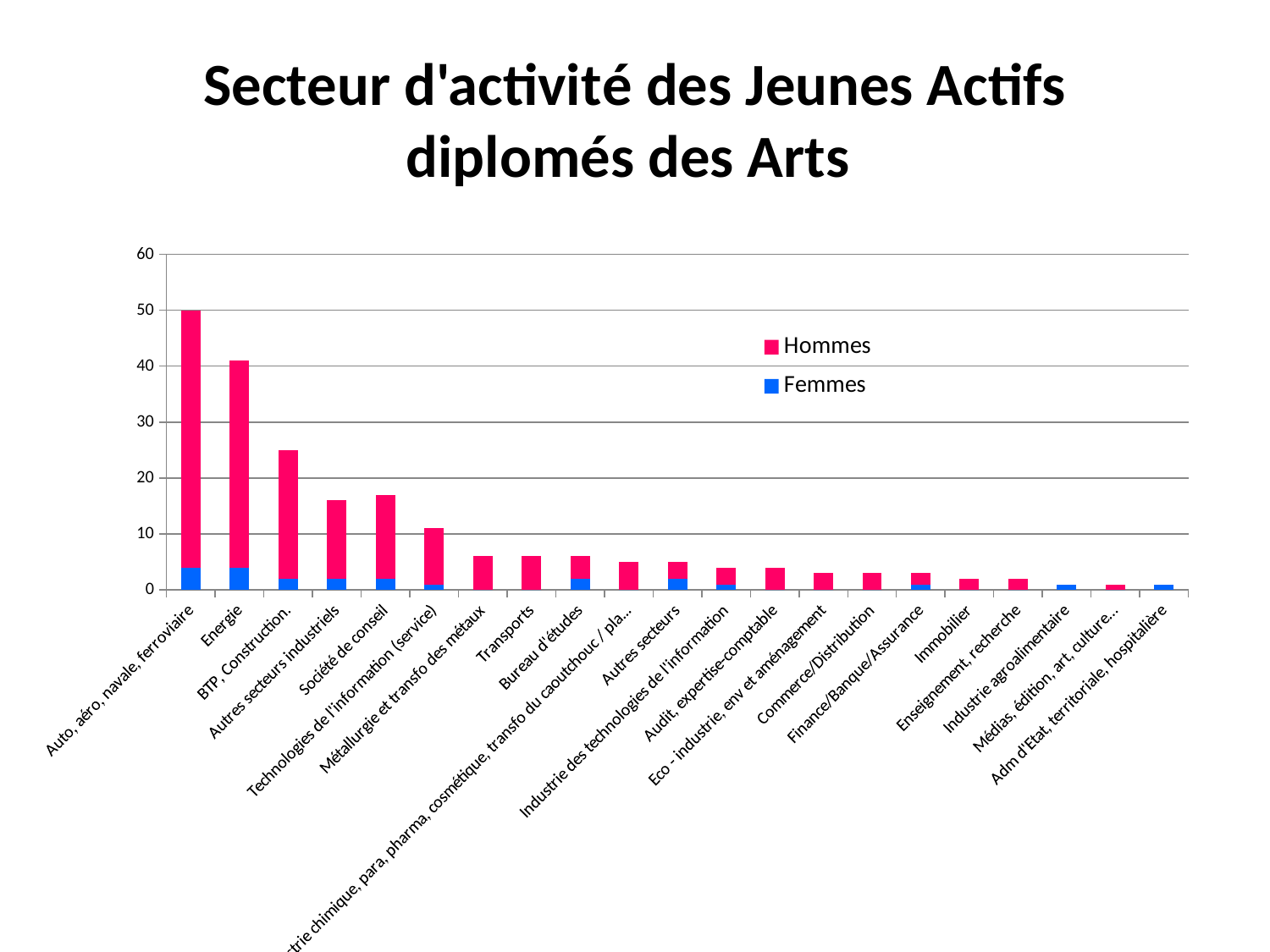
Which two series are listed in the legend? Hommes and Femmes Do the total bar heights generally rise or fall from left to right along the x axis? fall How many sectors (categories) are plotted on the x axis? 21 What kind of chart is shown on the slide? stacked bar chart Which sector has the tallest total bar? Auto, aéro, navale, ferroviaire Which has the larger total bar, Société de conseil or Transports? Société de conseil Is the total value for Energie greater or less than 30? greater Is the total value for BTP, Construction. greater or less than 30? less Is the total value for Technologies de l'information (service) greater or less than 20? less How many series does the legend list? 2 What colour represents the Femmes series? blue Which has the larger total bar, Energie or BTP, Construction.? Energie